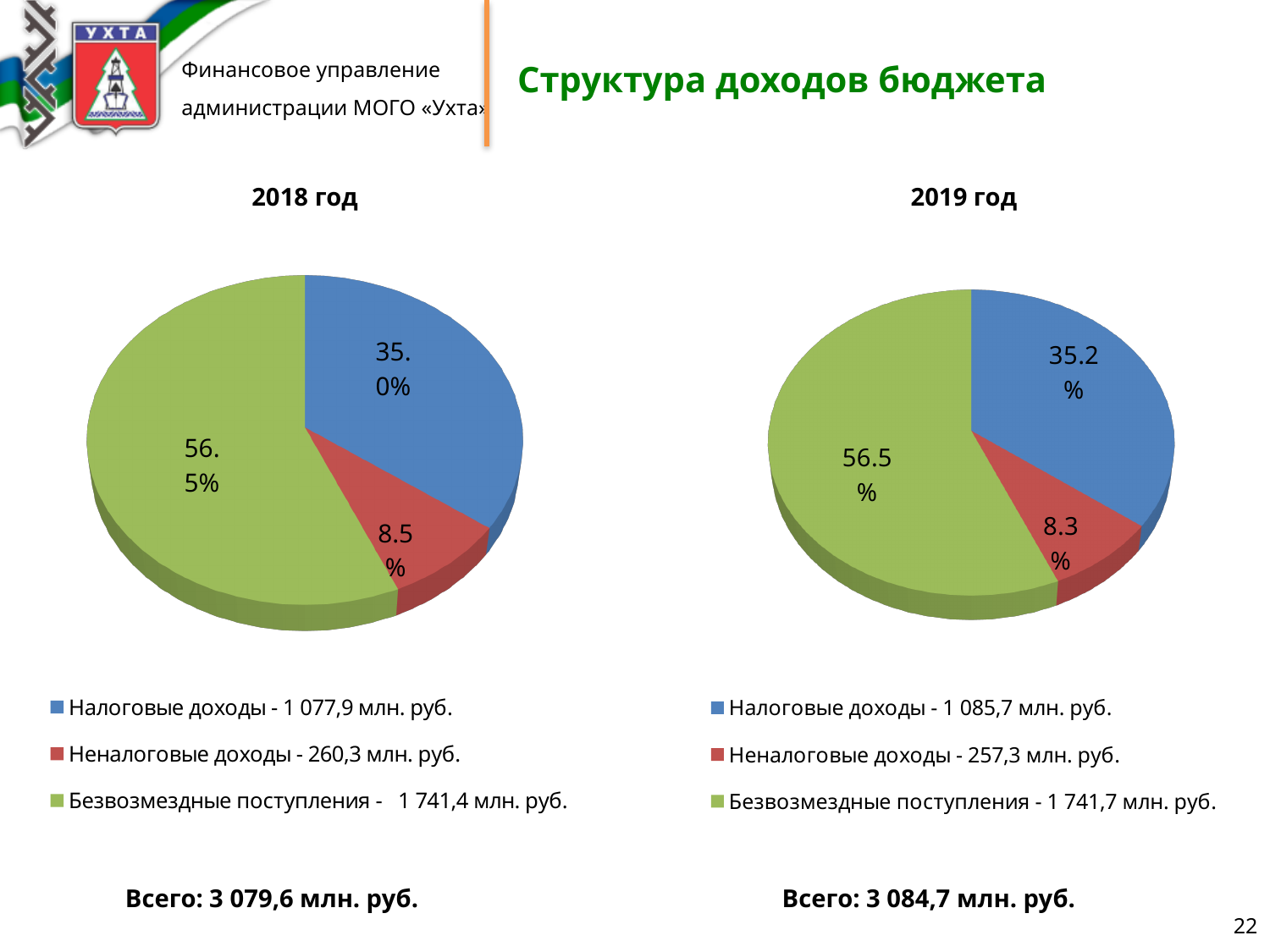
What is the total (Всего) shown under the 2019 год chart? 3 084,7 млн. руб. In the 2018 год chart, what share of the pie is Налоговые доходы? 35.0% In the 2019 год chart, which slice is larger: Налоговые доходы or Неналоговые доходы? Налоговые доходы In the 2019 год chart, which category has the smallest slice? Неналоговые доходы What type of chart is used on the slide for 2018 год? Pie chart According to the legend of the 2018 год chart, what is the amount for Неналоговые доходы? 260,3 млн. руб. In the 2018 год chart, which category has the largest slice? Безвозмездные поступления How many categories does the 2019 год pie chart have? 3 According to the legend of the 2019 год chart, what is the amount for Налоговые доходы? 1 085,7 млн. руб. In the 2019 год chart, what share of the pie is Налоговые доходы? 35.2% In the 2018 год chart, what share of the pie is Неналоговые доходы? 8.5%